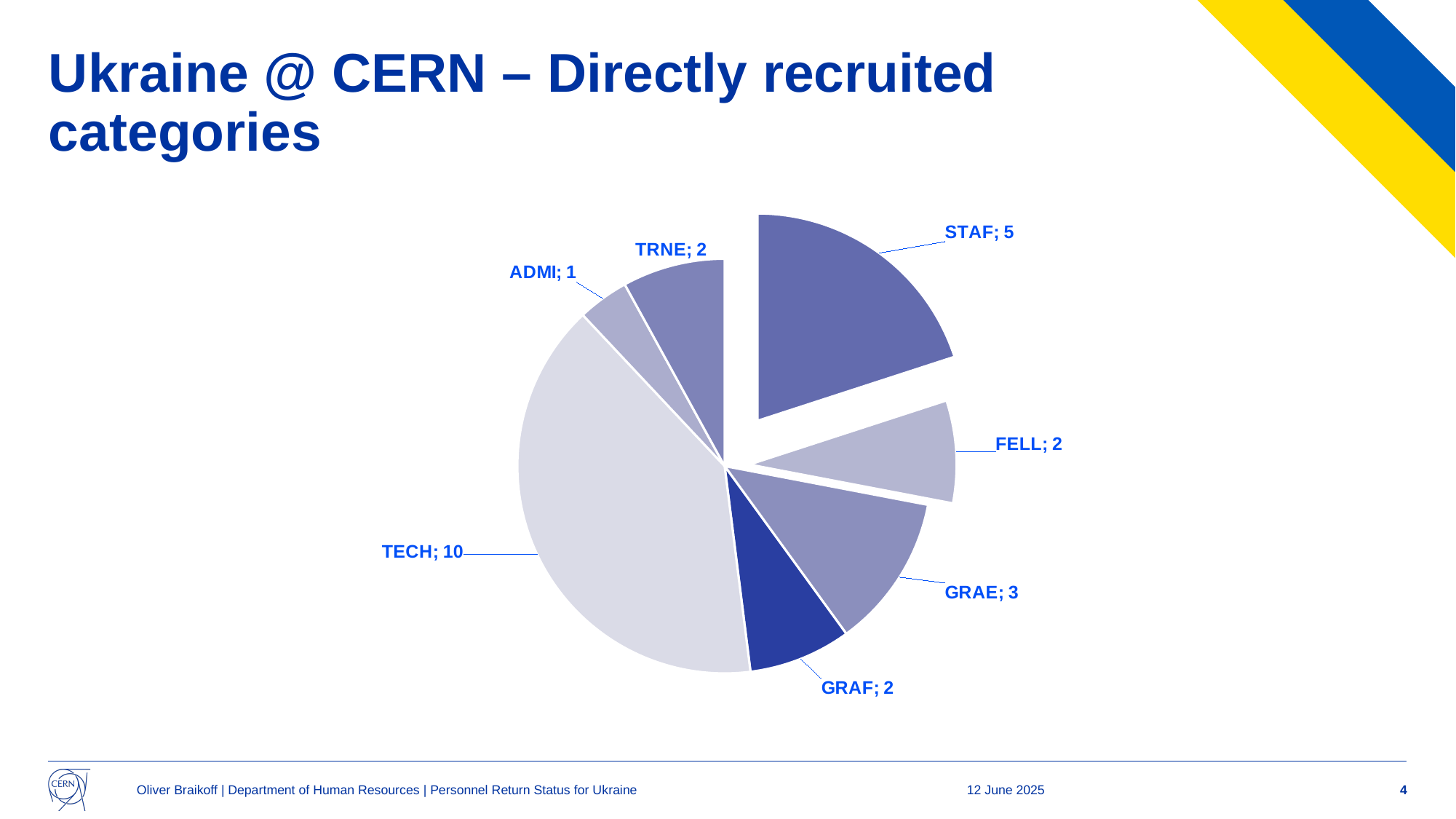
Which category has the largest slice? TECH What is the value for TECH? 10 What is the value for ADMI? 1 Which category has the smallest slice? ADMI What is the difference between the values for TECH and STAF? 5 Which is larger, the value for GRAE or the value for FELL? GRAE What kind of chart is shown on the slide? Pie chart How many categories does the pie chart show? 7 What share of the pie does TECH represent? 40% What is the title of the slide containing the pie chart? Ukraine @ CERN – Directly recruited categories What is the value for STAF? 5 What is the value for GRAE? 3